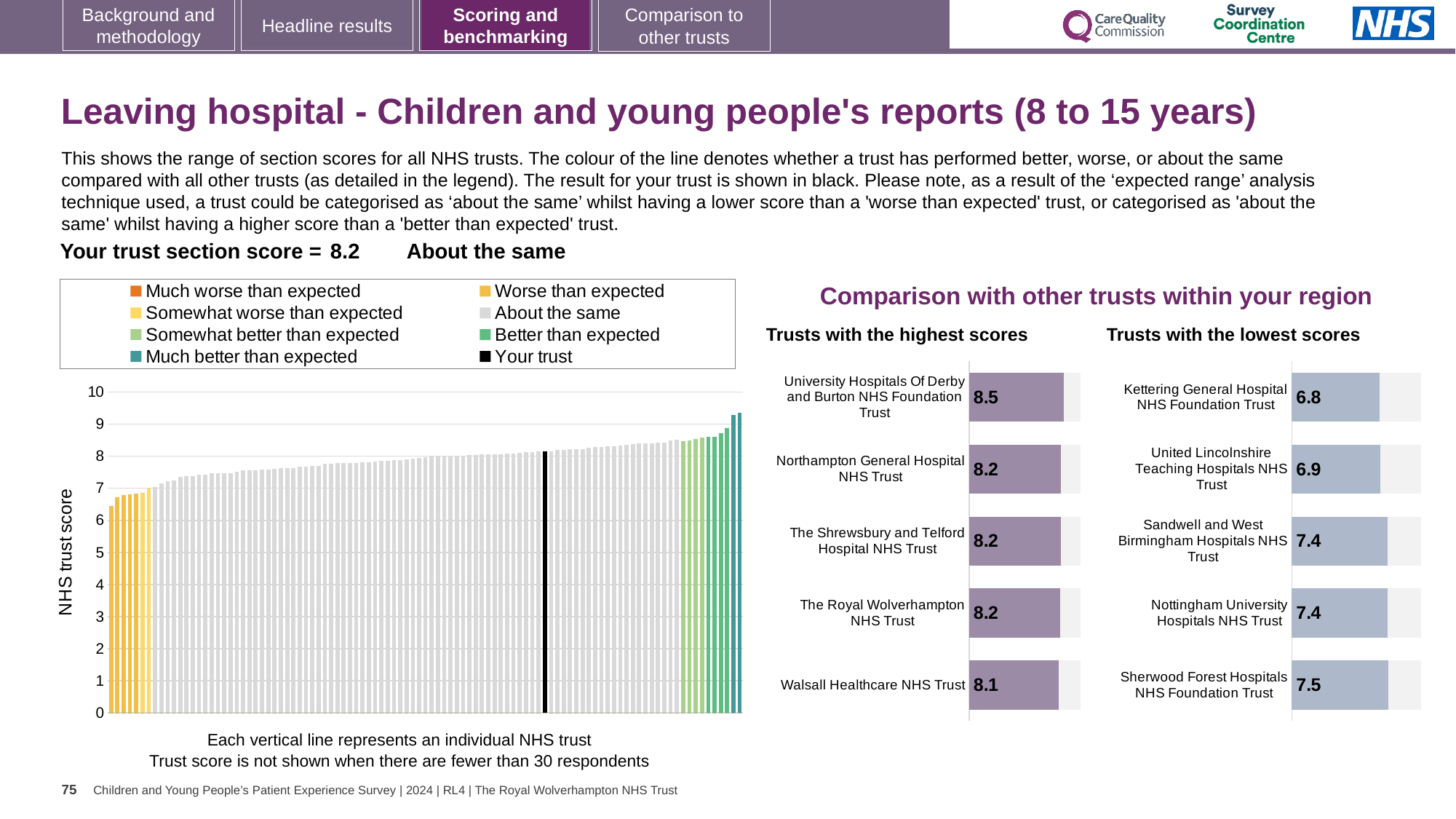
In the 'Trusts with the lowest scores' chart, what is the difference between the scores of Sherwood Forest Hospitals NHS Foundation Trust and Kettering General Hospital NHS Foundation Trust? 0.7 In the 'Trusts with the lowest scores' chart, which has the higher score: Sherwood Forest Hospitals NHS Foundation Trust or United Lincolnshire Teaching Hospitals NHS Trust? Sherwood Forest Hospitals NHS Foundation Trust In the main NHS trust score chart, is the value of the leftmost bar greater or less than 7? less How many trusts are shown in the 'Trusts with the highest scores' chart? 5 In the main NHS trust score chart, do the values rise or fall from left to right? rise In the 'Trusts with the lowest scores' chart, which trust has the lowest score? Kettering General Hospital NHS Foundation Trust In the 'Trusts with the highest scores' chart, what is the difference between the scores of University Hospitals Of Derby and Burton NHS Foundation Trust and Walsall Healthcare NHS Trust? 0.4 In the 'Trusts with the highest scores' chart, what is the score for University Hospitals Of Derby and Burton NHS Foundation Trust? 8.5 How many entries does the legend of the main NHS trust score chart list? 8 In the 'Trusts with the lowest scores' chart, what is the score for Kettering General Hospital NHS Foundation Trust? 6.8 In the 'Trusts with the highest scores' chart, which trust has the highest score? University Hospitals Of Derby and Burton NHS Foundation Trust What kind of chart is the main chart showing NHS trust scores on the left of the slide? bar chart